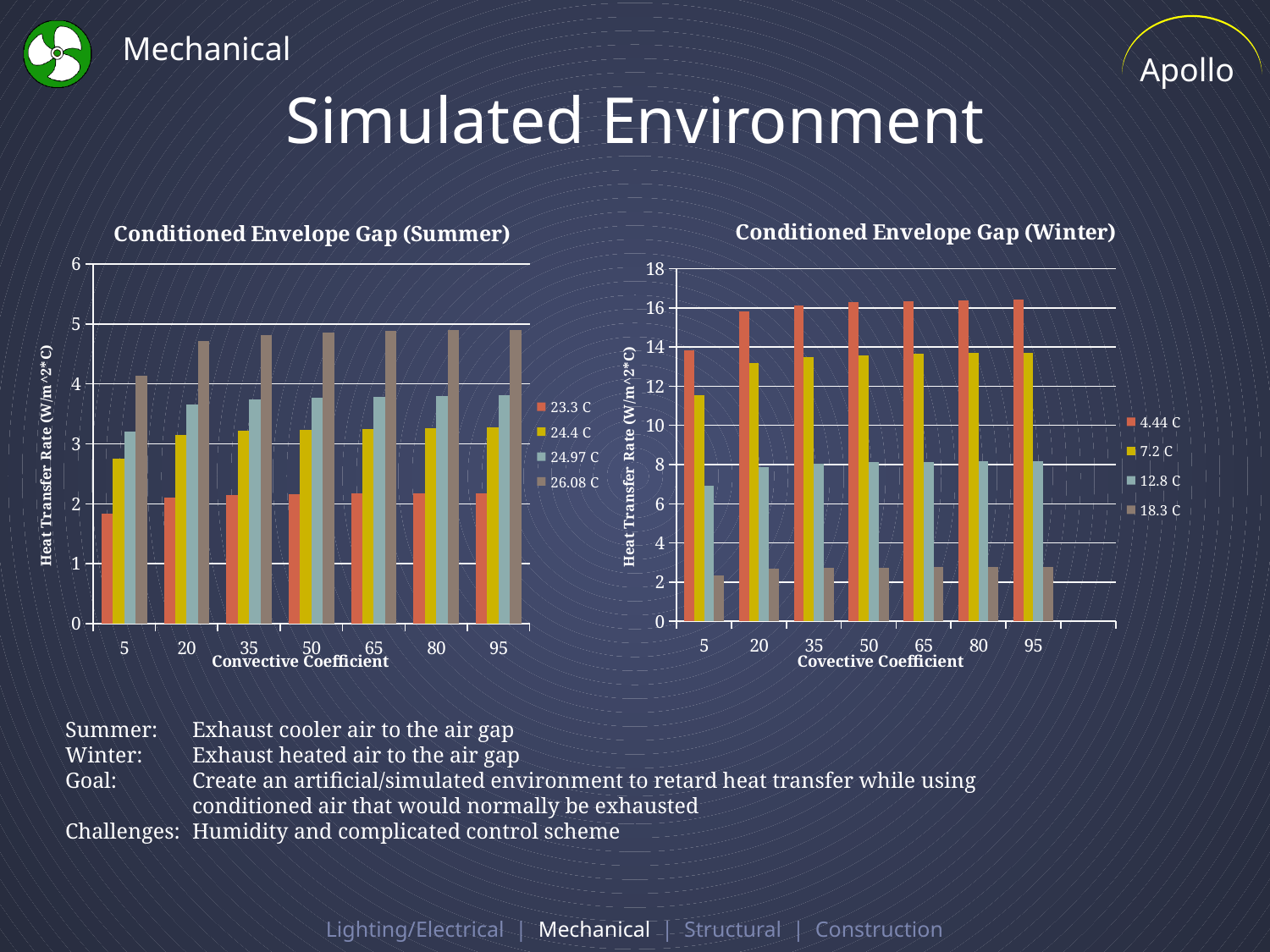
In the Conditioned Envelope Gap (Winter) chart, is the value for the 18.3 C series at convective coefficient 5 greater or less than 4? less In the Conditioned Envelope Gap (Winter) chart, which series has the lowest value at convective coefficient 5? 18.3 C What kind of chart is the Conditioned Envelope Gap (Summer) chart? bar chart What is the y-axis title of the Conditioned Envelope Gap (Winter) chart? Heat Transfer Rate (W/m^2*C) In the Conditioned Envelope Gap (Winter) chart, is the value for the 4.44 C series at convective coefficient 95 greater or less than 14? greater In the Conditioned Envelope Gap (Summer) chart, which series has the highest value at convective coefficient 95? 26.08 C In the Conditioned Envelope Gap (Summer) chart, is the value for the 23.3 C series at convective coefficient 5 greater or less than 2? less In the Conditioned Envelope Gap (Summer) chart, do the values for the 26.08 C series rise or fall as the convective coefficient increases? rise What is the x-axis title of the Conditioned Envelope Gap (Summer) chart? Convective Coefficient How many convective coefficient categories are shown on the x axis of the Conditioned Envelope Gap (Winter) chart? 7 How many series does the legend of the Conditioned Envelope Gap (Summer) chart list? 4 In the Conditioned Envelope Gap (Winter) chart, at convective coefficient 20, which is larger: the 4.44 C series or the 7.2 C series? 4.44 C